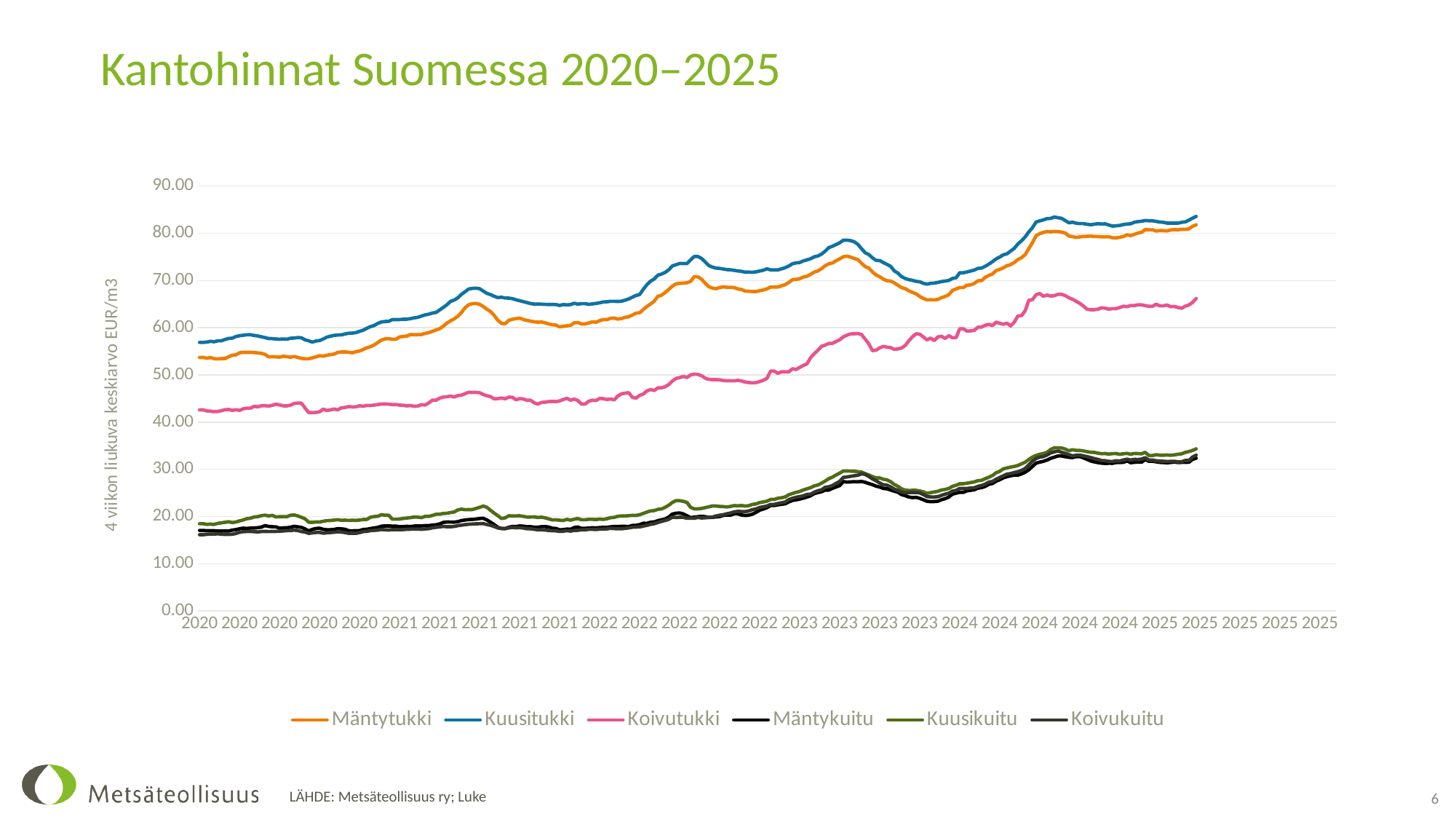
Is the value for Kuusikuitu at the end of the period greater or less than 30? greater Does the Mäntytukki series generally rise or fall from 2020 to 2025? rise How many series does the legend list? 6 What kind of chart is shown on the slide? line chart What is the title of the chart? Kantohinnat Suomessa 2020–2025 Which is higher at the end of the period, Kuusitukki or Mäntytukki? Kuusitukki Which of the three tukki series (Mäntytukki, Kuusitukki, Koivutukki) has the lowest values? Koivutukki Is the value for Koivutukki at the start of 2020 greater or less than 50? less What is the label on the vertical axis? 4 viikon liukuva keskiarvo EUR/m3 Which is higher at the start of 2020, Koivutukki or Kuusikuitu? Koivutukki Which series has the highest values across the whole period? Kuusitukki Is the value for Kuusitukki at the end of the period greater or less than 80? greater